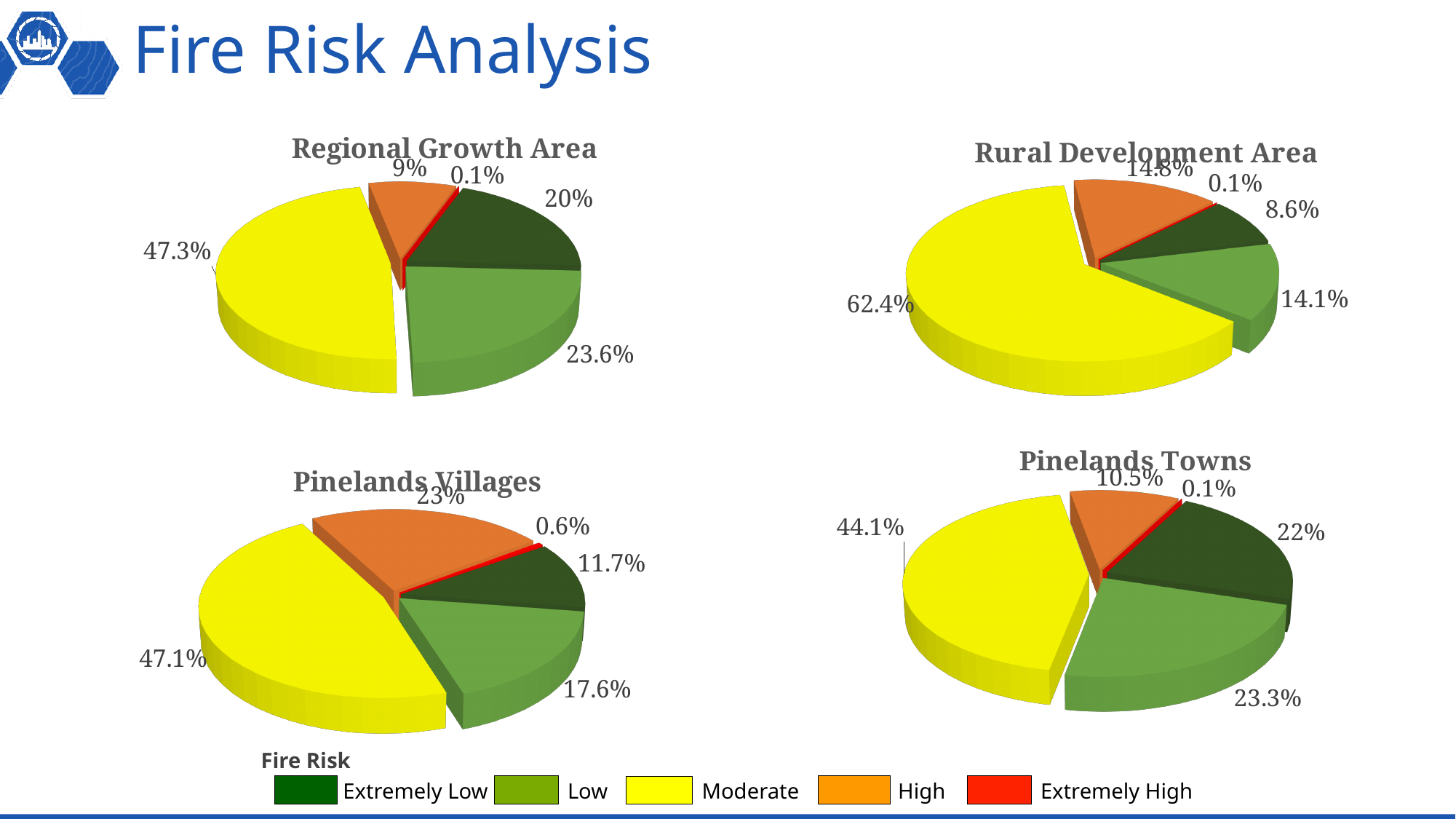
What type of chart is used for the Pinelands Villages data? Pie chart In the Pinelands Towns chart, what share is the Low fire risk slice? 23.3% Which colour represents the Moderate fire risk category in the legend? Yellow How many fire risk categories does the legend list? 5 In the Rural Development Area chart, what share is the Moderate fire risk slice? 62.4% How many slices does the Rural Development Area pie chart have? 5 In the Regional Growth Area chart, what share is the Moderate fire risk slice? 47.3% In the Pinelands Towns chart, which is larger: the Extremely Low slice or the High slice? Extremely Low In the Pinelands Villages chart, which fire risk category has the smallest slice? Extremely High In the Pinelands Villages chart, what share is the High fire risk slice? 23% In the Regional Growth Area chart, what is the difference between the Low slice and the Extremely Low slice? 3.6% In the Rural Development Area chart, which fire risk category has the largest slice? Moderate